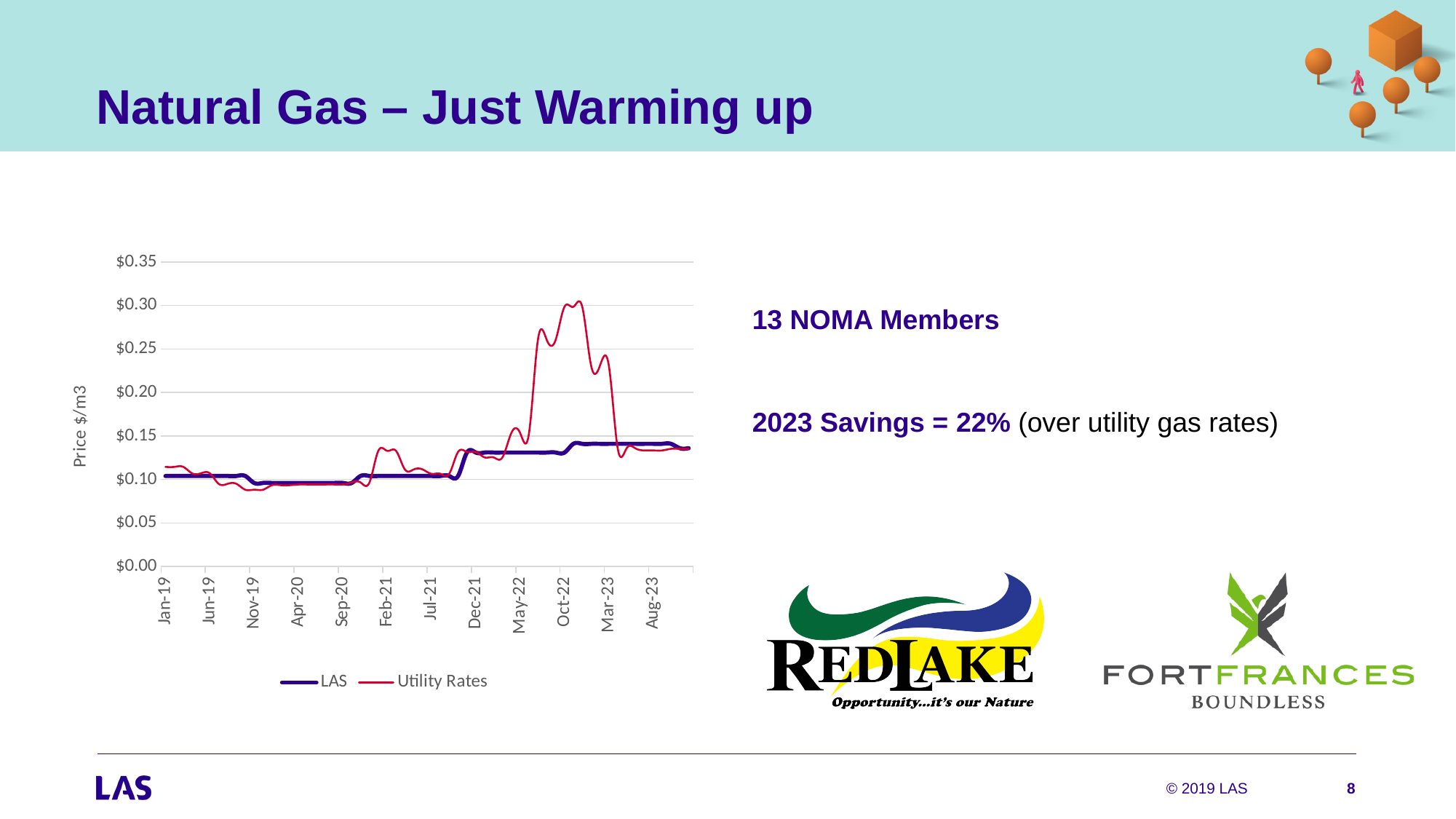
How many series does the chart's legend list? 2 Is the Utility Rates value at Jan-19 greater or less than $0.15? less How many date labels are shown along the chart's x axis? 12 Around Oct-22, which series has the higher value, LAS or Utility Rates? Utility Rates Is the LAS value at Jan-19 greater or less than $0.15? less What is the label on the chart's vertical axis? Price $/m3 Is the Utility Rates value around Oct-22 greater or less than $0.25? greater Which series reaches the highest value anywhere on the chart? Utility Rates Does the LAS line overall rise or fall from Jan-19 to Aug-23? rise What kind of chart is shown on the slide? line chart What are the two series named in the chart's legend? LAS and Utility Rates